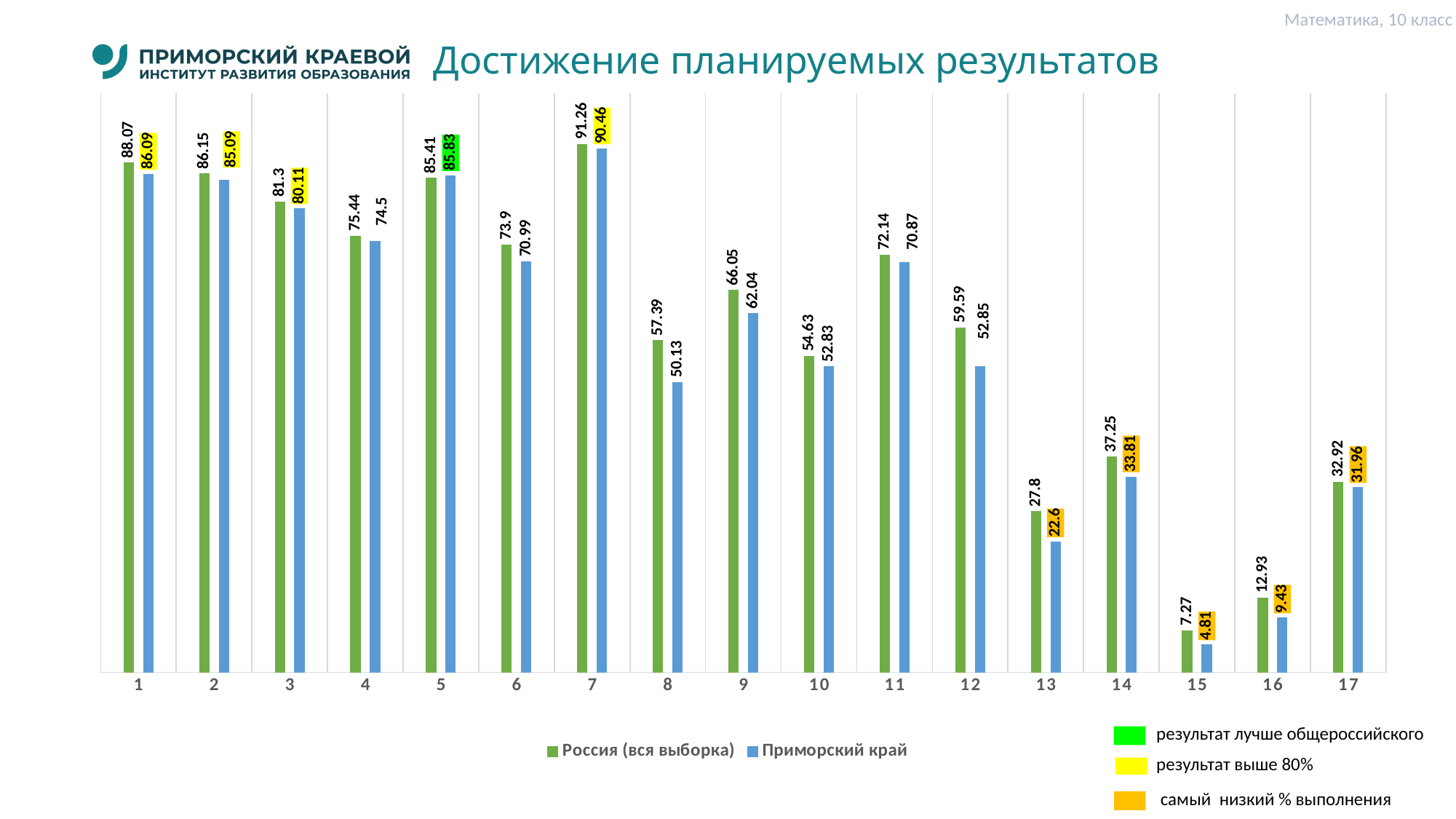
What is the value for Приморский край at category 7? 90.46 What is the difference between Россия (вся выборка) and Приморский край at category 1? 1.98 What is the difference between Россия (вся выборка) and Приморский край at category 16? 3.5 Which category has the lowest value for Россия (вся выборка)? 15 What kind of chart is shown on the slide? bar chart How many categories are shown on the x axis? 17 What is the value for Приморский край at category 16? 9.43 What is the title of the chart? Достижение планируемых результатов At category 5, which series has the larger value: Россия (вся выборка) or Приморский край? Приморский край What is the value for Россия (вся выборка) at category 13? 27.8 How many series does the legend list? 2 Which category has the highest value for Приморский край? 7